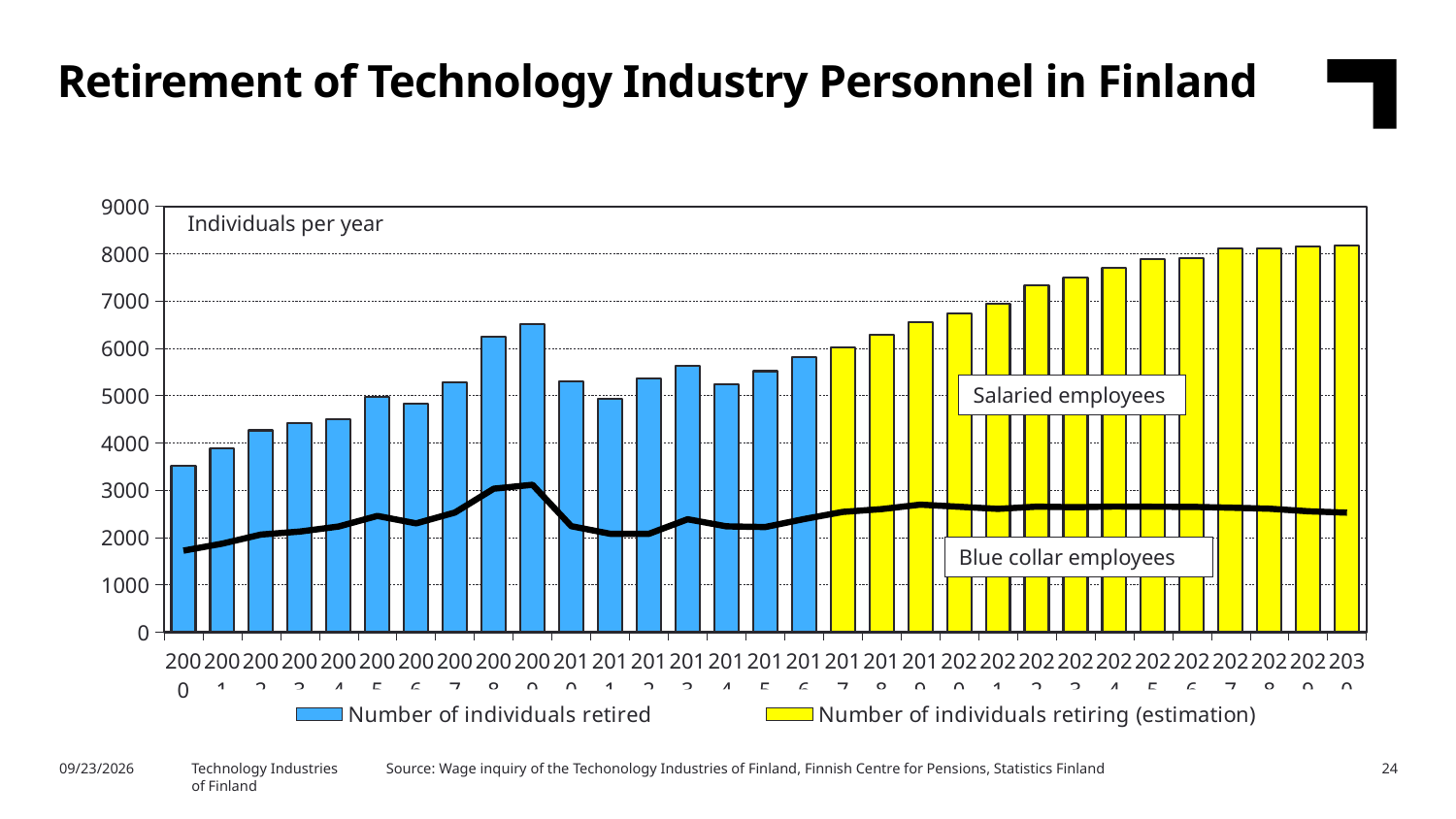
Is the value for 2030 greater or less than 8000? greater How many series does the legend list? 2 What are the two series named in the legend? Number of individuals retired; Number of individuals retiring (estimation) Do the estimated values (yellow bars) rise or fall from 2017 to 2030? Rise Is the value for 2000 greater or less than 3000? greater Which year has the lowest bar in the chart? 2000 What kind of chart is shown on the slide? Combination bar and line chart Is the value for 2016 greater or less than 6000? less What colour are the bars for the 'Number of individuals retiring (estimation)' series? Yellow How many years (bars) are shown on the x axis? 31 Which bar is taller, 2008 or 2009? 2009